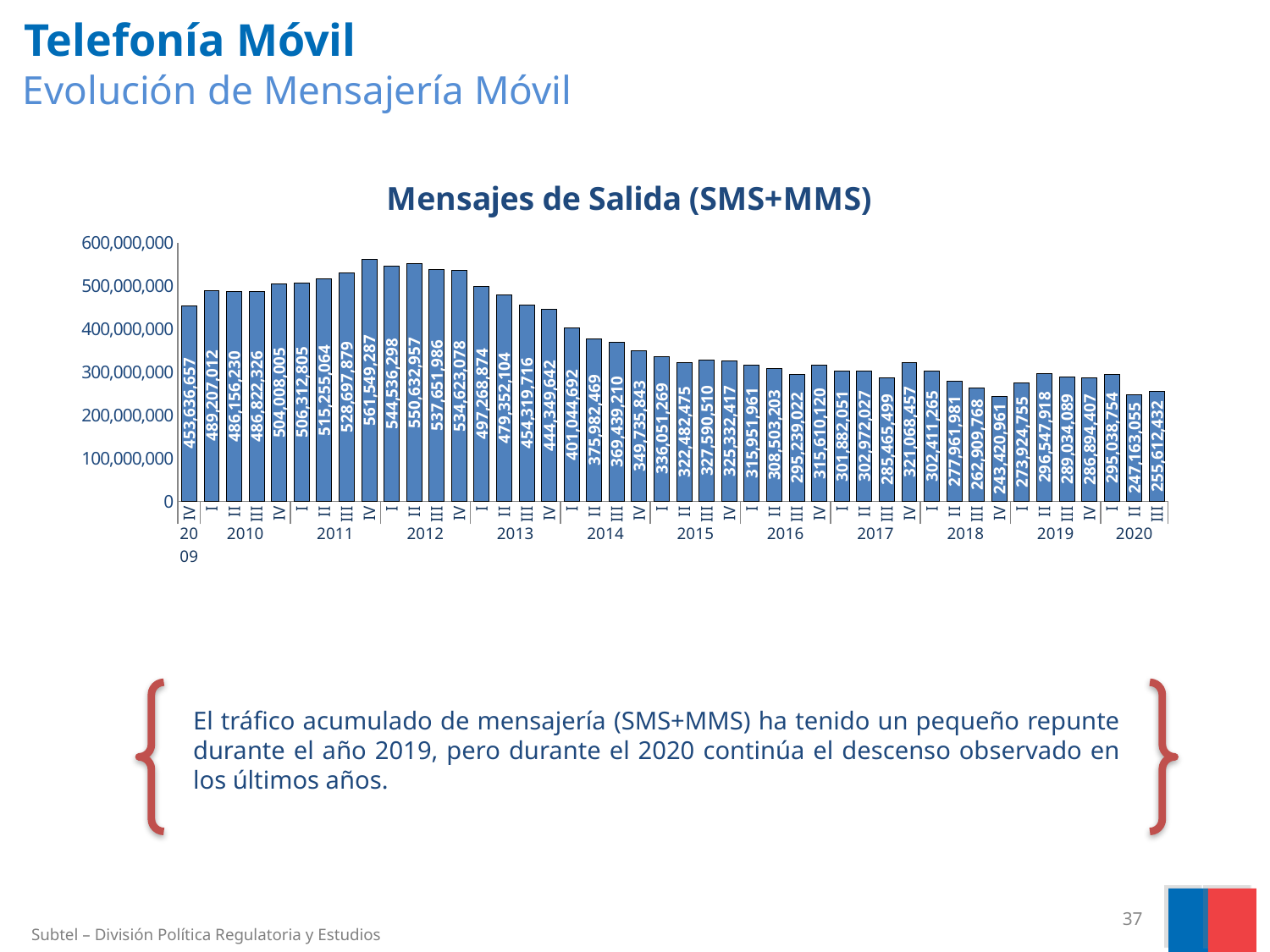
What is the value of Mensajes de Salida for quarter IV of 2011? 561,549,287 What is the difference between the values for quarter III of 2020 and quarter II of 2020? 8,449,377 Which quarter has the highest value of Mensajes de Salida? IV 2011 Which is larger, the value for quarter I of 2019 or the value for quarter II of 2019? II 2019 Overall, do the values rise or fall from 2012 to 2020? Fall What is the value of Mensajes de Salida for quarter III of 2020? 255,612,432 How many quarterly bars are plotted in the chart? 44 What is the value of Mensajes de Salida for quarter IV of 2009? 453,636,657 What is the title of the chart? Mensajes de Salida (SMS+MMS) Which quarter has the lowest value of Mensajes de Salida? IV 2018 What type of chart is shown on the slide? Bar chart What is the difference between the highest value (IV 2011) and the lowest value (IV 2018)? 318,128,326